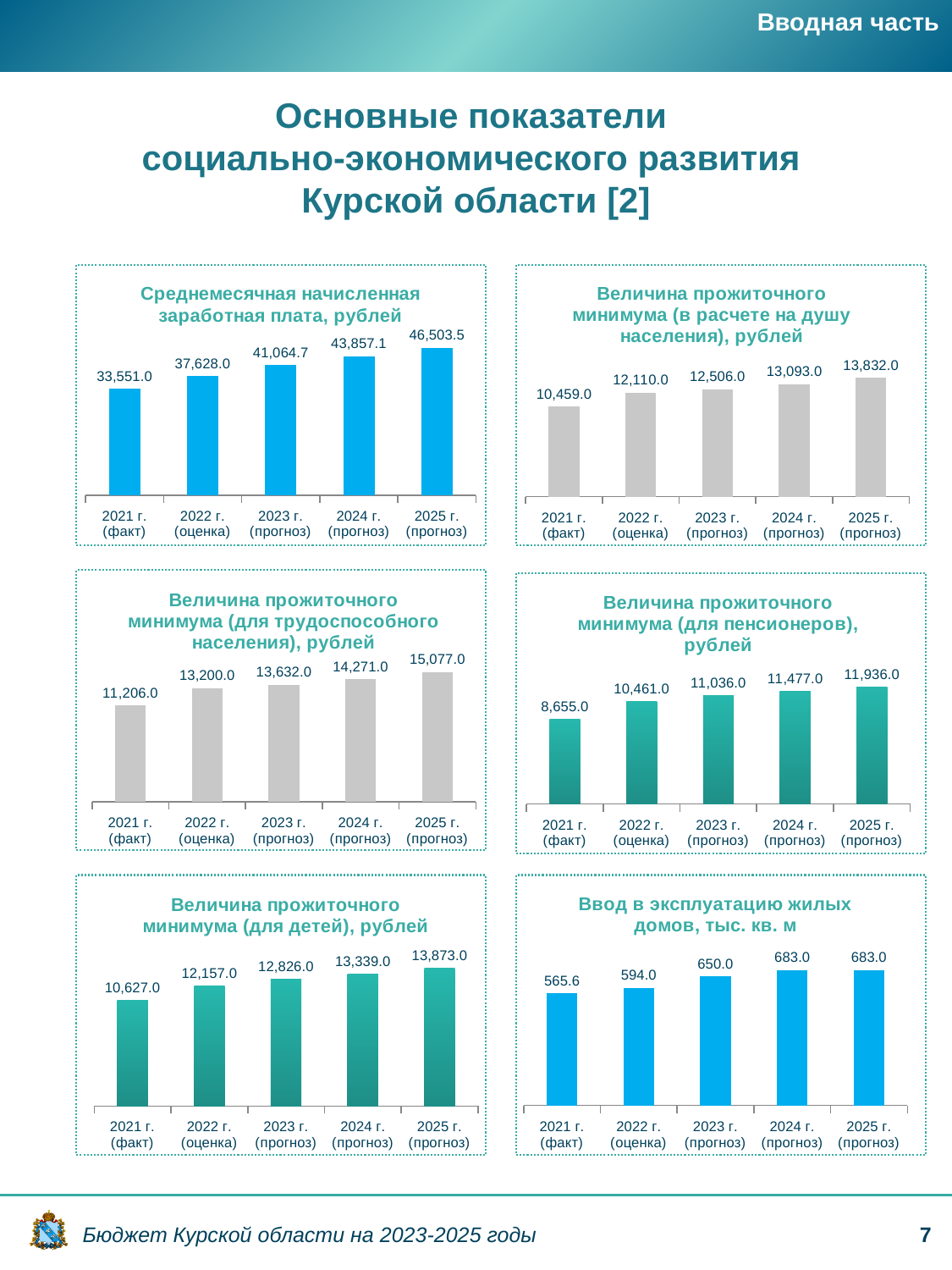
In the chart 'Величина прожиточного минимума (для пенсионеров), рублей', what is the difference between the 2025 г. (прогноз) and 2021 г. (факт) values? 3,281.0 In the chart 'Величина прожиточного минимума (в расчете на душу населения), рублей', which year has the lowest value? 2021 г. (факт) In the chart 'Ввод в эксплуатацию жилых домов, тыс. кв. м', what is the value for 2021 г. (факт)? 565.6 In the chart 'Среднемесячная начисленная заработная плата, рублей', what is the difference between the 2025 г. (прогноз) and 2021 г. (факт) values? 12,952.5 In the chart 'Ввод в эксплуатацию жилых домов, тыс. кв. м', do the values rise or fall from 2021 г. to 2025 г.? rise In the chart 'Величина прожиточного минимума (в расчете на душу населения), рублей', what is the value for 2022 г. (оценка)? 12,110.0 In the chart 'Среднемесячная начисленная заработная плата, рублей', what is the value for 2023 г. (прогноз)? 41,064.7 In the chart 'Величина прожиточного минимума (для пенсионеров), рублей', what is the value for 2021 г. (факт)? 8,655.0 How many categories (years) are shown in the chart 'Ввод в эксплуатацию жилых домов, тыс. кв. м'? 5 In the chart 'Среднемесячная начисленная заработная плата, рублей', which year has the highest value? 2025 г. (прогноз) In the chart 'Величина прожиточного минимума (для детей), рублей', which is larger: the value for 2023 г. (прогноз) or 2024 г. (прогноз)? 2024 г. (прогноз) In the chart 'Величина прожиточного минимума (для трудоспособного населения), рублей', what is the value for 2025 г. (прогноз)? 15,077.0